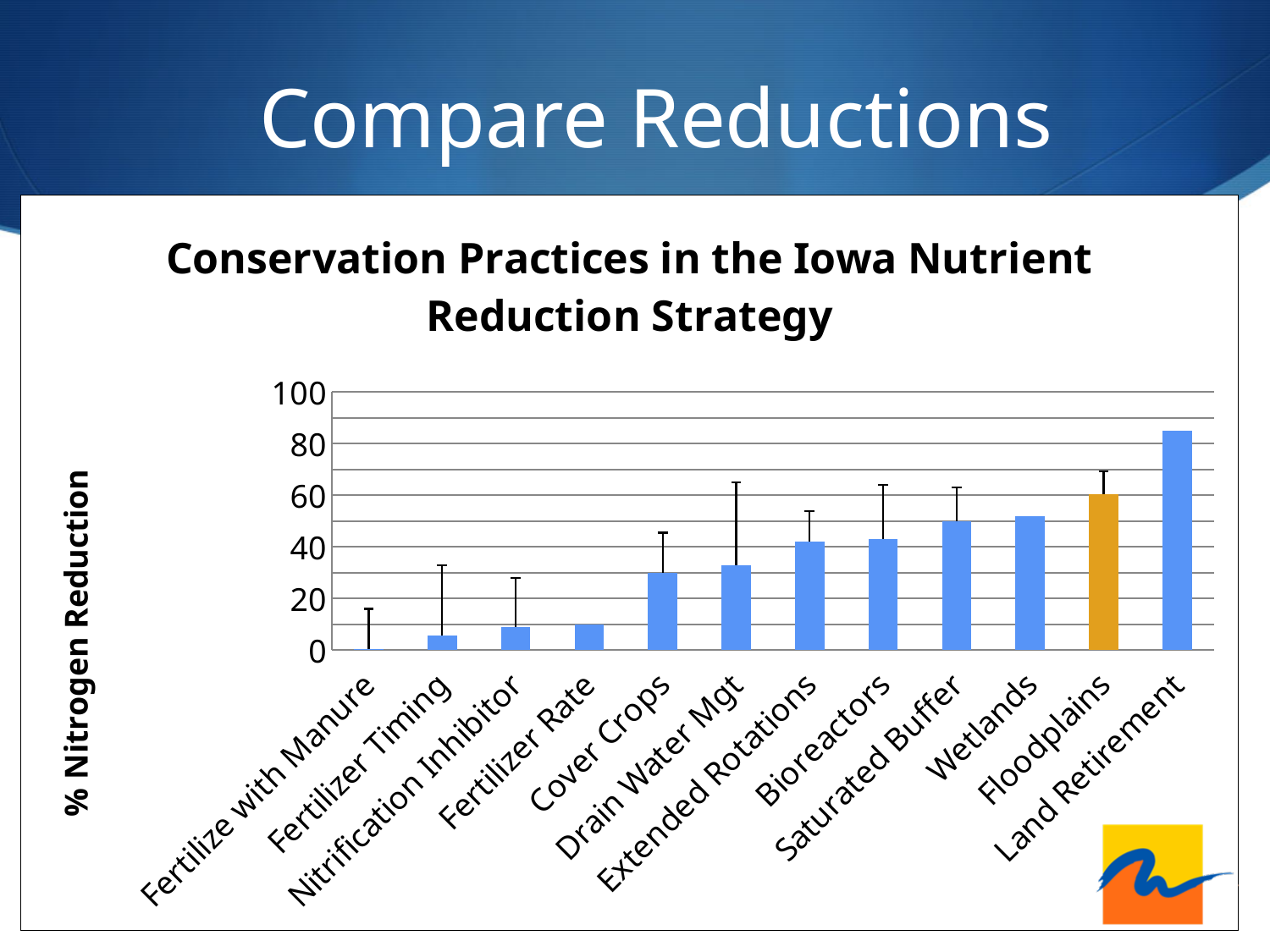
Which conservation practice has the lowest % nitrogen reduction? Fertilize with Manure How many conservation practices are shown on the x axis of the chart? 12 What kind of chart is shown on the slide? Bar chart Is the value for Bioreactors greater or less than 60? less Which conservation practice has the highest % nitrogen reduction? Land Retirement Is the value for Fertilizer Timing greater or less than 20? less What is the label on the vertical axis of the chart? % Nitrogen Reduction Is the value for Cover Crops greater or less than 20? greater Do the bar values generally rise or fall from left to right along the x axis? Rise Which has a higher % nitrogen reduction, Cover Crops or Wetlands? Wetlands